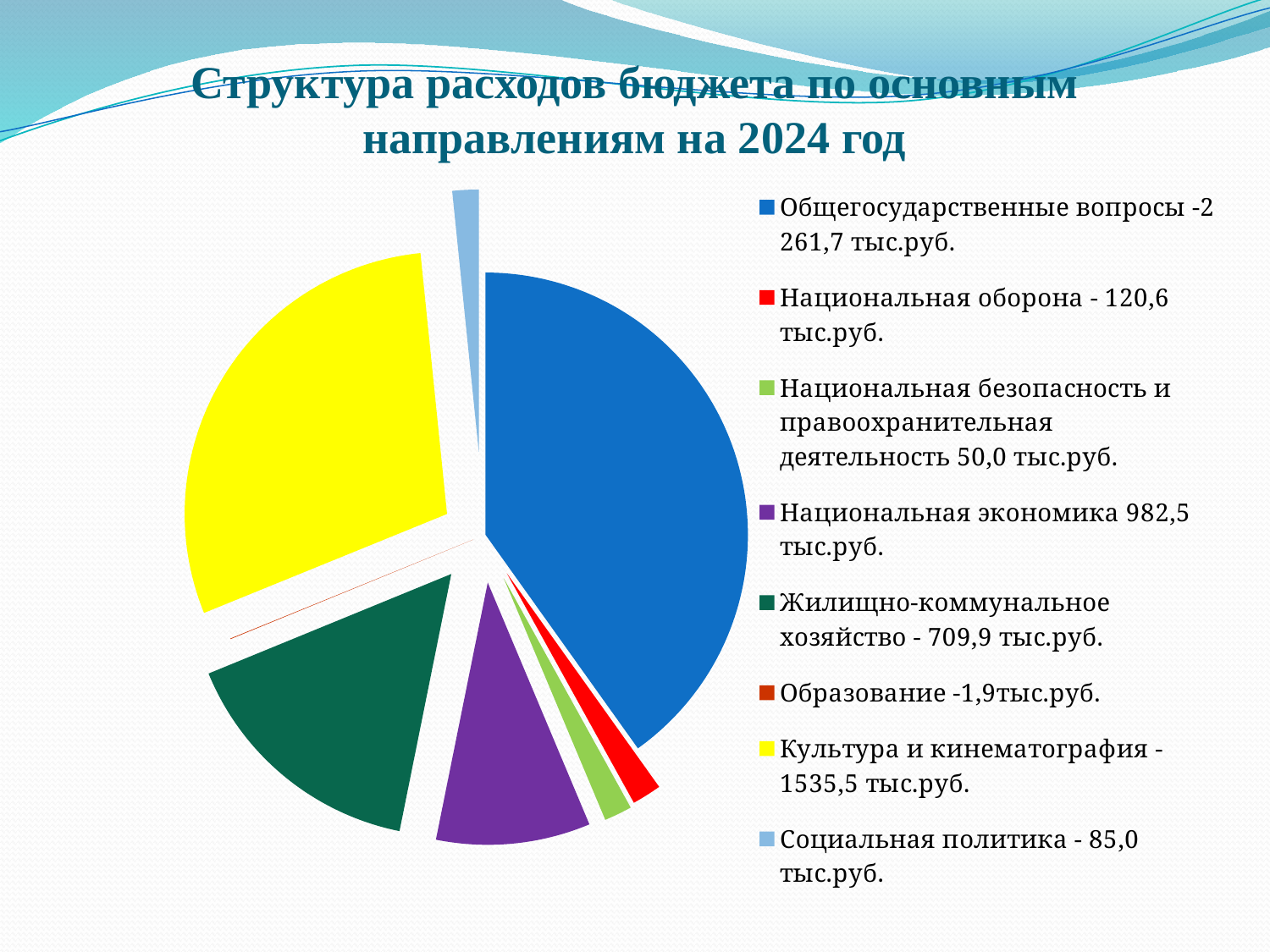
What colour is the slice for Культура и кинематография? yellow What is the value given for Жилищно-коммунальное хозяйство? 709,9 тыс.руб. What is the value given for Культура и кинематография? 1535,5 тыс.руб. What is the difference between Национальная экономика and Национальная оборона? 861,9 тыс.руб. What kind of chart is shown on the slide? pie chart Which category has the largest slice of the pie? Общегосударственные вопросы What is the difference between Культура и кинематография and Жилищно-коммунальное хозяйство? 825,6 тыс.руб. Which is larger, Национальная оборона or Национальная безопасность и правоохранительная деятельность? Национальная оборона Which category has the smallest value in the pie chart? Образование How many categories does the legend of the pie chart list? 8 What is the value given for Социальная политика? 85,0 тыс.руб. What is the value given for Национальная экономика? 982,5 тыс.руб.